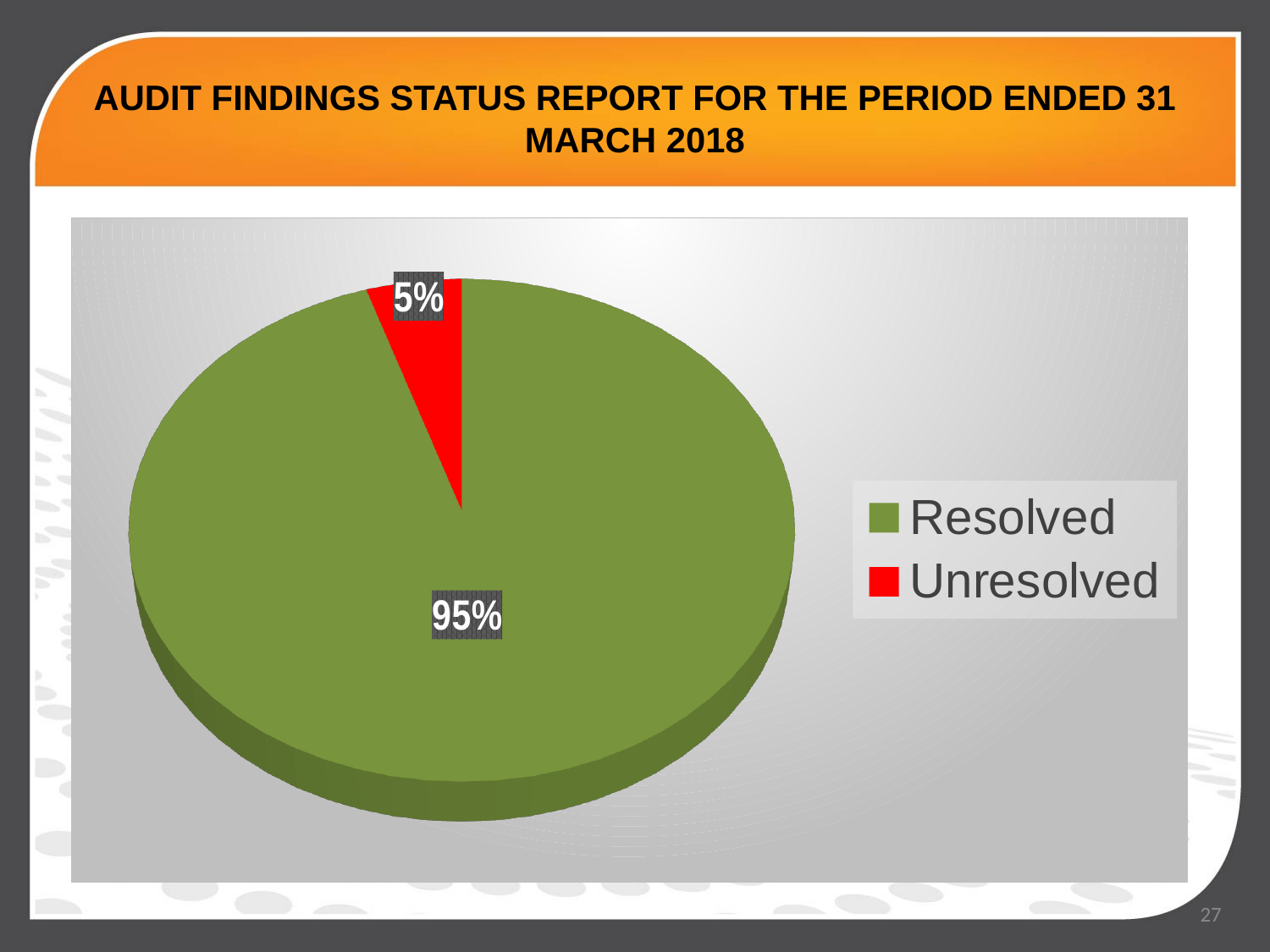
What is the difference in percentage points between the Resolved and Unresolved shares? 90 What percentage of audit findings are shown as Unresolved? 5% What is the title of the slide containing the chart? AUDIT FINDINGS STATUS REPORT FOR THE PERIOD ENDED 31 MARCH 2018 Which category has the largest share of the pie? Resolved How many entries does the legend list? 2 What share of the pie does the Unresolved slice represent? 5% Which category has the smallest share of the pie? Unresolved Which is larger, the Resolved share or the Unresolved share? Resolved What kind of chart is shown on the slide? Pie chart How many categories does the pie chart show? 2 What percentage of audit findings are shown as Resolved? 95% What colour is used for the Unresolved slice? Red